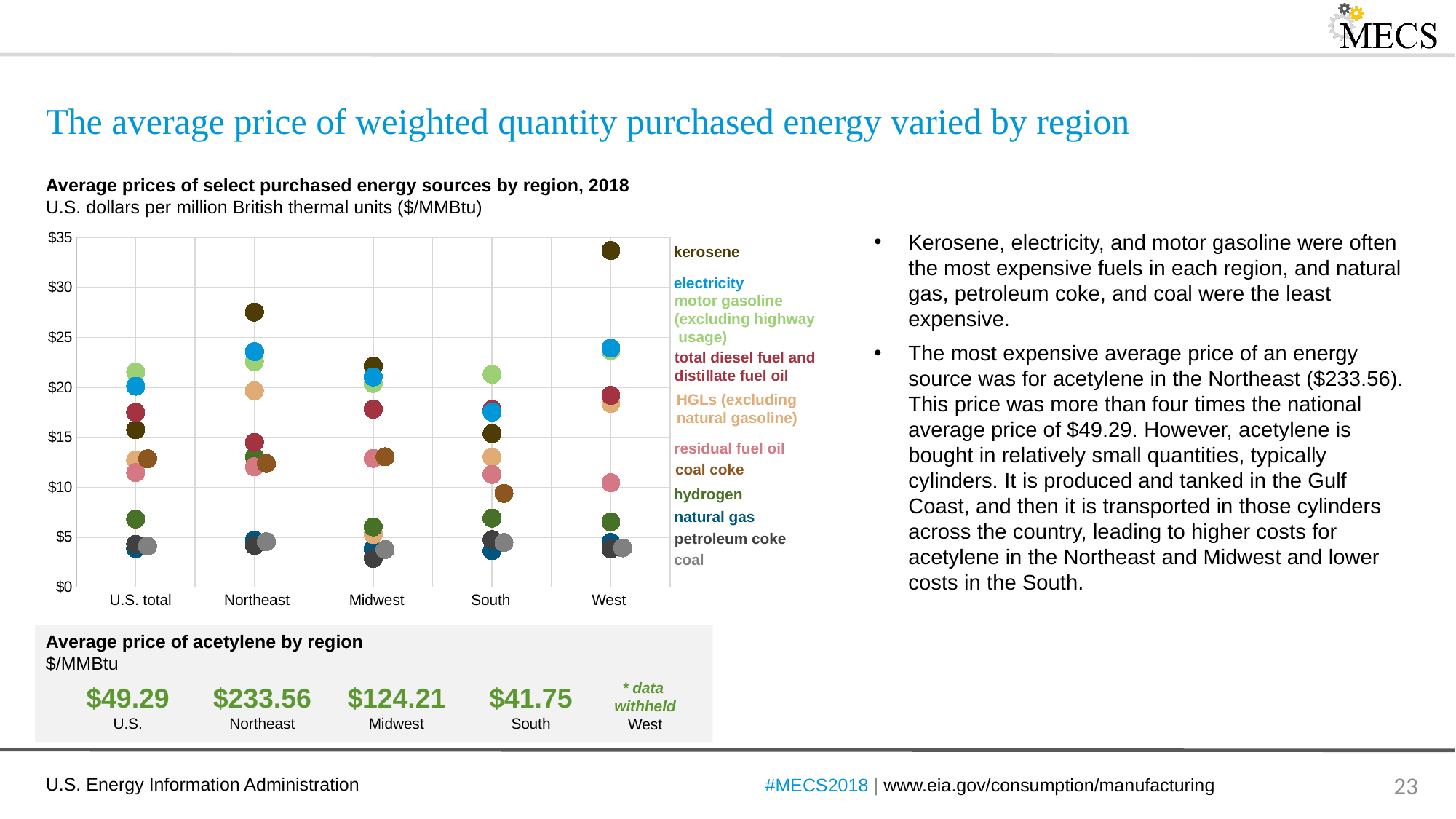
Which is higher in the West: the electricity price or the natural gas price? electricity How many energy sources does the chart's legend list? 11 Is the kerosene price in the West greater or less than $30? greater What unit is used on the chart's y axis? U.S. dollars per million British thermal units ($/MMBtu) Is the kerosene price in the Northeast greater or less than $25? greater Is the electricity price in the South greater or less than $20? less In which region is the kerosene price highest? West How many regions (categories) are shown on the x axis of the chart? 5 In which region is the electricity price lowest? South What kind of chart is used to show average prices of select purchased energy sources by region? scatter (dot) chart Which region has the higher kerosene price: Northeast or Midwest? Northeast